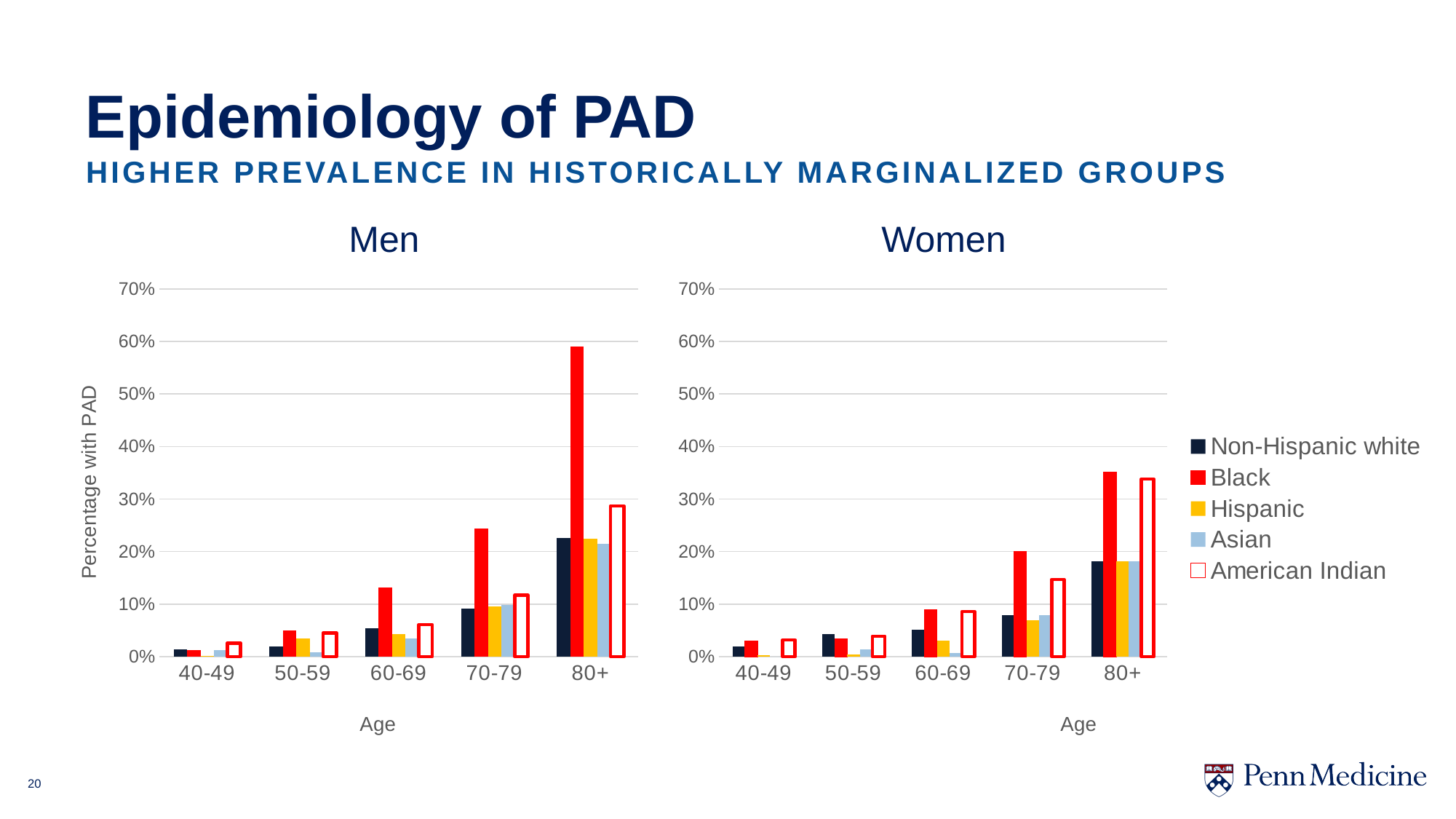
In the Women chart, which series has the highest value in the 70-79 age group? Black Is the value for Black in the 80+ age group larger in the Men chart or the Women chart? Men What is the label on the y axis of the Men chart? Percentage with PAD What kind of chart is the Men chart? bar chart How many age categories are shown on the x axis of the Women chart? 5 In the Men chart, do the values for Black rise or fall as age increases along the x axis? rise In the Men chart, which series has the highest value in the 80+ age group? Black In the Men chart, is the value for Black in the 80+ age group greater or less than 50%? greater How many series does the legend list? 5 In the Women chart, is the value for Non-Hispanic white in the 80+ age group greater or less than 20%? less In the Men chart, is the value for Black in the 70-79 age group greater or less than 20%? greater